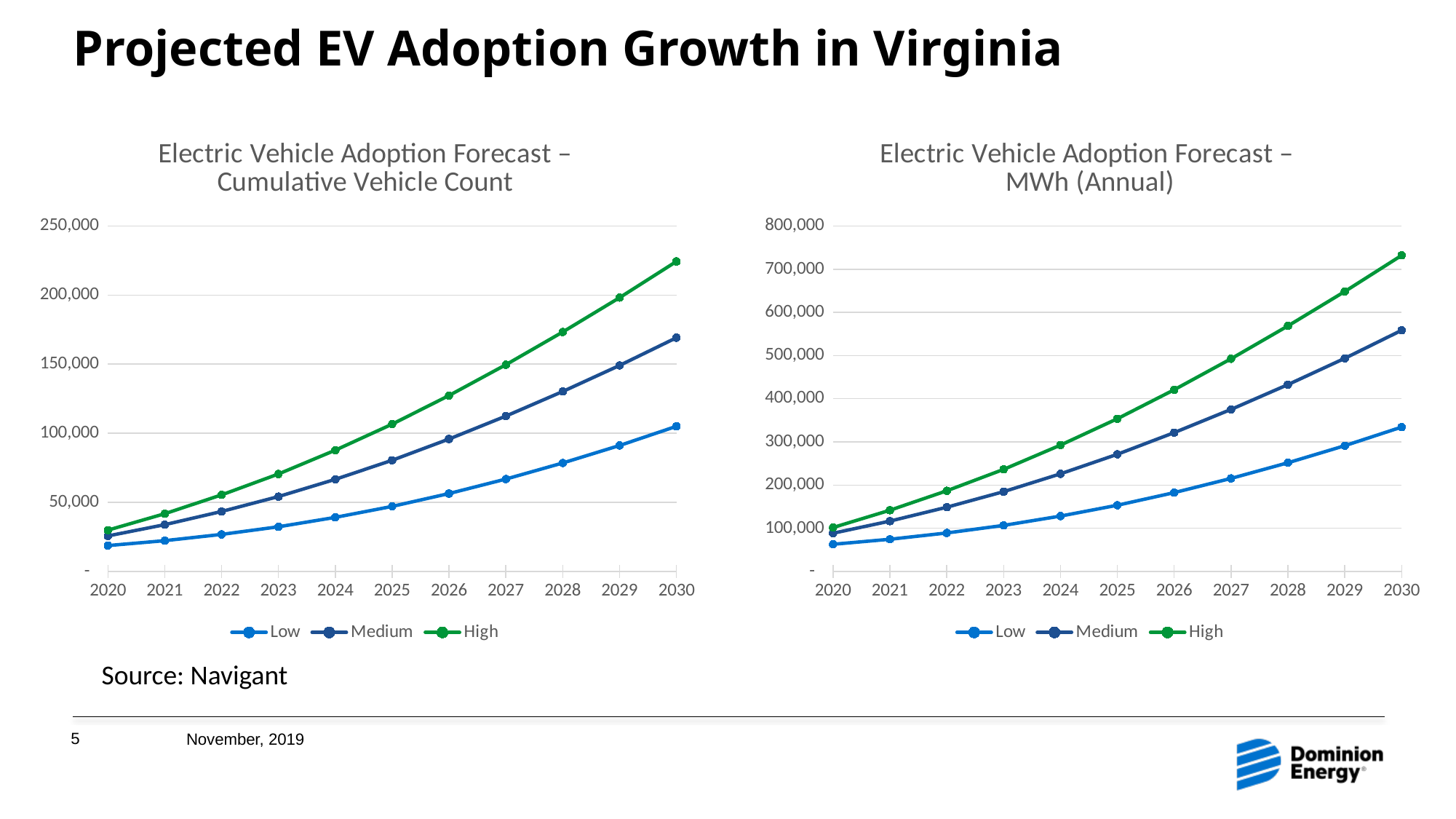
In the Cumulative Vehicle Count chart, which series has the highest value in 2030? High In the MWh (Annual) chart, is the value for High in 2025 greater or less than 400,000? less In the MWh (Annual) chart, is the value for High in 2030 greater or less than 700,000? greater What kind of chart is the Cumulative Vehicle Count chart? Line chart In the Cumulative Vehicle Count chart, is the value for High in 2030 greater or less than 200,000? greater How many years are plotted on the x axis of the Cumulative Vehicle Count chart? 11 In the MWh (Annual) chart, which is larger in 2028: Medium or Low? Medium How many series does the legend of the MWh (Annual) chart list? 3 In the MWh (Annual) chart, which series has the lowest value in 2030? Low